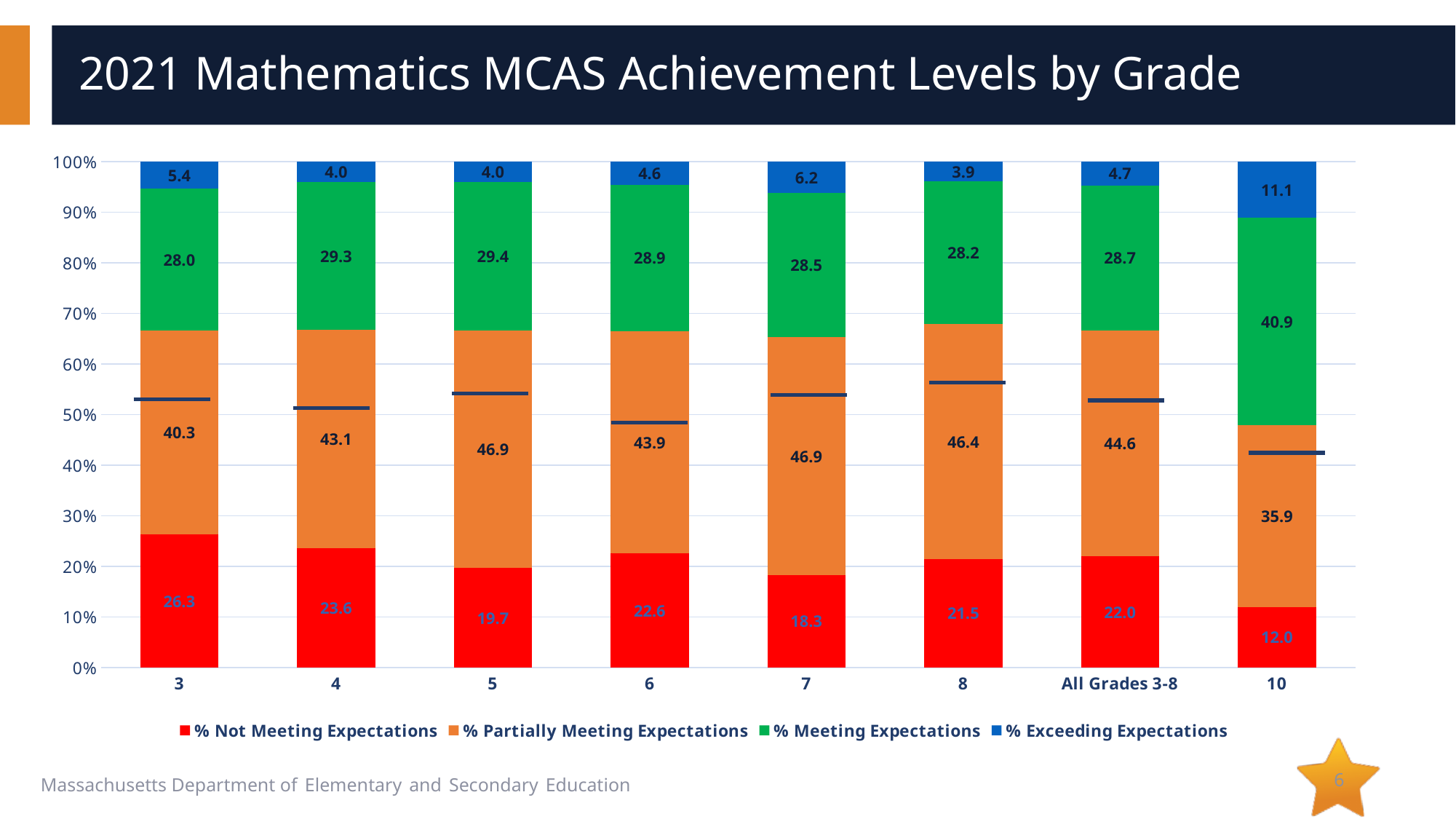
Which has a larger % Partially Meeting Expectations, grade 4 or grade 5? Grade 5 Which grade has the lowest % Not Meeting Expectations? 10 What is the difference between the % Not Meeting Expectations for grade 3 and for grade 10? 14.3 What is the % Not Meeting Expectations value for grade 7? 18.3 How many categories are shown on the x axis? 8 What is the % Meeting Expectations value for grade 10? 40.9 Which grade has the highest % Not Meeting Expectations? 3 Which grade has the highest % Exceeding Expectations? 10 What is the % Partially Meeting Expectations value for All Grades 3-8? 44.6 How many series does the legend list? 4 What kind of chart is shown on the slide? Stacked bar chart What is the % Exceeding Expectations value for grade 3? 5.4